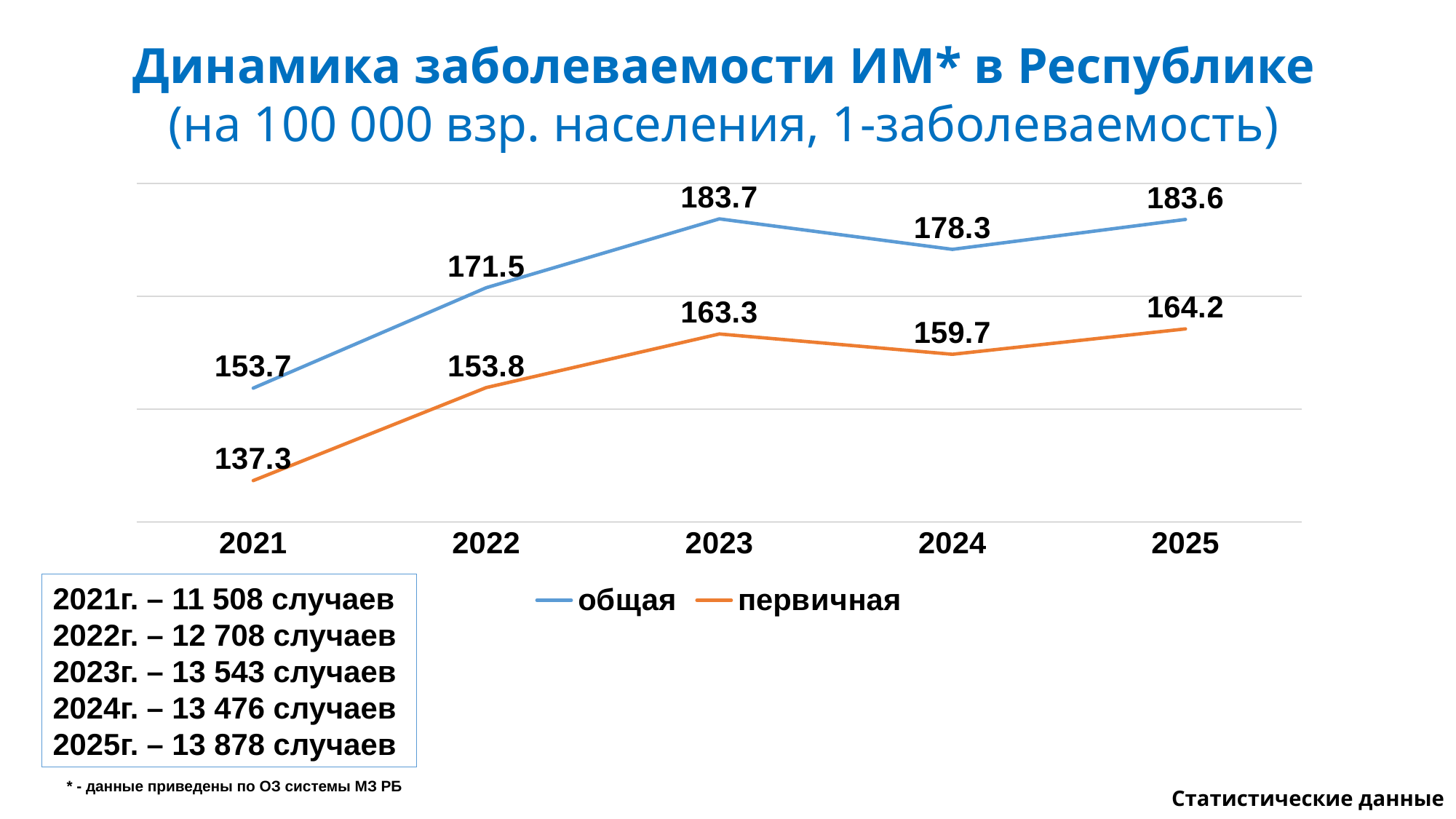
What is the value of the первичная series in 2021? 137.3 What type of chart is shown on the slide? line chart In which year is the общая series lowest? 2021 What is the difference between the общая and первичная values in 2025? 19.4 What is the value of the общая series in 2023? 183.7 How many years are plotted on the x axis? 5 What is the value of the общая series in 2022? 171.5 Does the общая series rise or fall from 2021 to 2023? rise What is the value of the первичная series in 2024? 159.7 Which is larger: the общая value in 2024 or the общая value in 2022? 2024 How many series does the legend list? 2 In which year is the первичная series lowest? 2021